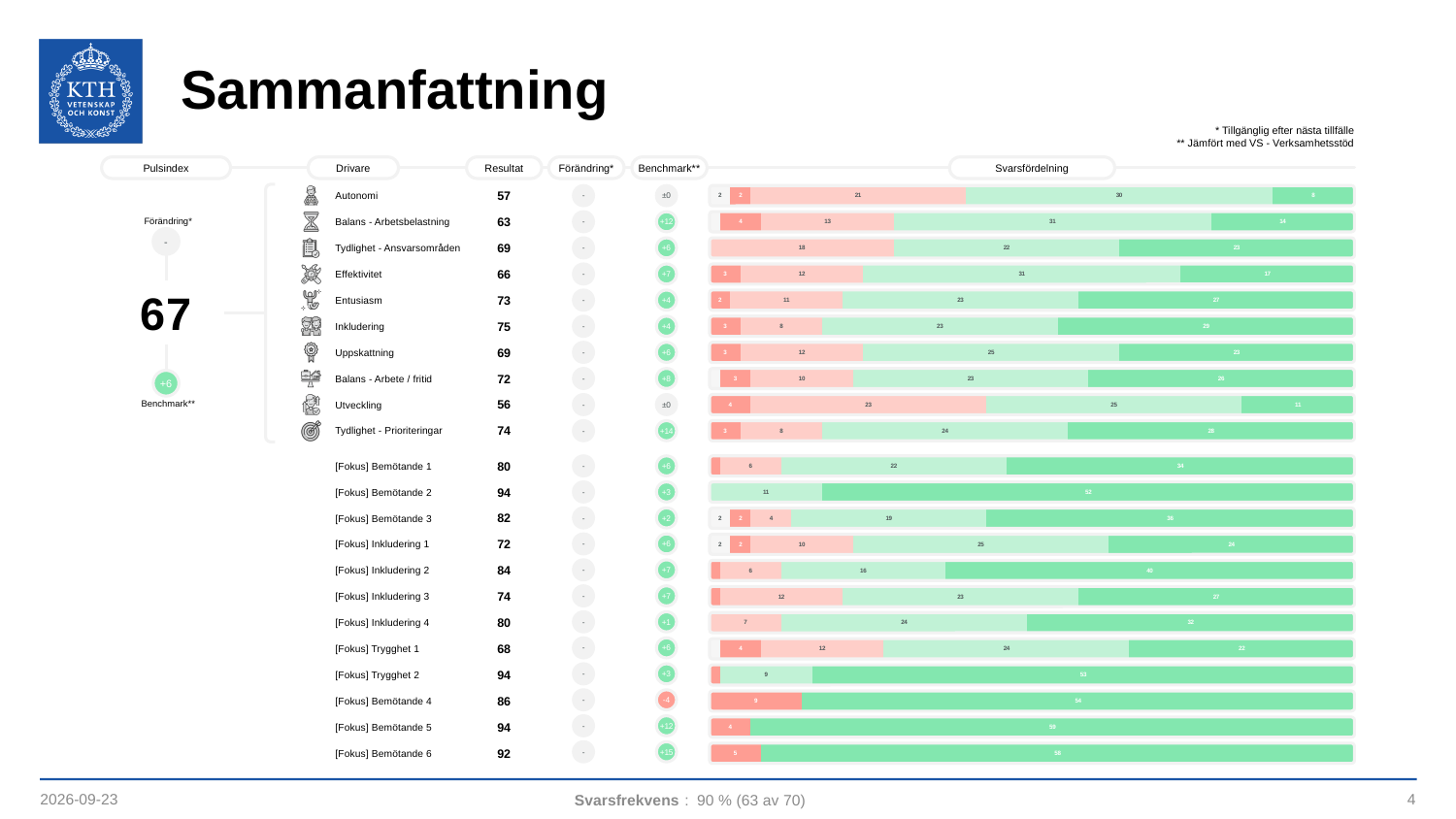
How many rows (Drivare and Fokus items) are listed in the table? 22 What is the Benchmark** value shown for Balans - Arbetsbelastning? +12 Among the ten Drivare rows (Autonomi through Tydlighet - Prioriteringar), which has the lowest Resultat? Utveckling What is the difference in Resultat between [Fokus] Bemötande 2 and [Fokus] Bemötande 1? 14 Among the ten Drivare rows (Autonomi through Tydlighet - Prioriteringar), which has the highest Resultat? Inkludering What is the Svarsfrekvens stated at the bottom of the slide? 90 % (63 av 70) What is the Pulsindex value shown on the slide? 67 What is the Resultat value for Tydlighet - Prioriteringar? 74 What is the Resultat value for [Fokus] Bemötande 6? 92 What kind of chart is used in the Svarsfördelning column? Stacked bar chart What is the Resultat value for Autonomi? 57 Which has a higher Resultat, Entusiasm or Effektivitet? Entusiasm